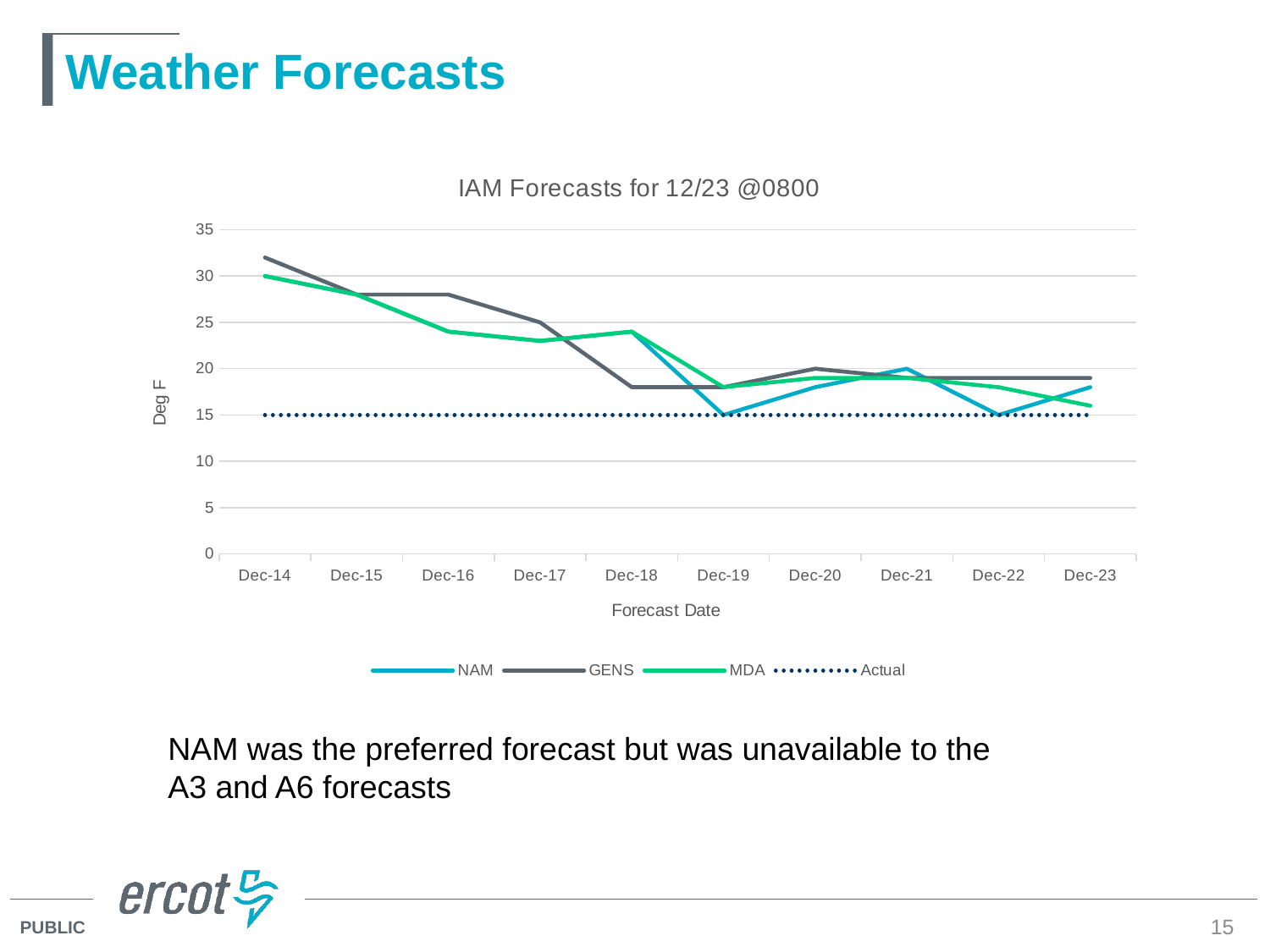
Which series has the highest value at Dec-14? GENS What is the label of the y axis? Deg F How many series does the legend list? 4 What kind of chart is shown on the slide? line chart What is the value of the Actual series across the forecast dates? 15 At Dec-18, which is higher, the GENS value or the MDA value? MDA Is the GENS value for Dec-14 greater or less than 30? greater Does the GENS series rise or fall from Dec-14 to Dec-18? fall What is the title of the chart? IAM Forecasts for 12/23 @0800 How many forecast dates are shown on the x axis? 10 Is the NAM value for Dec-16 greater or less than 25? less Is the GENS value for Dec-18 greater or less than 20? less